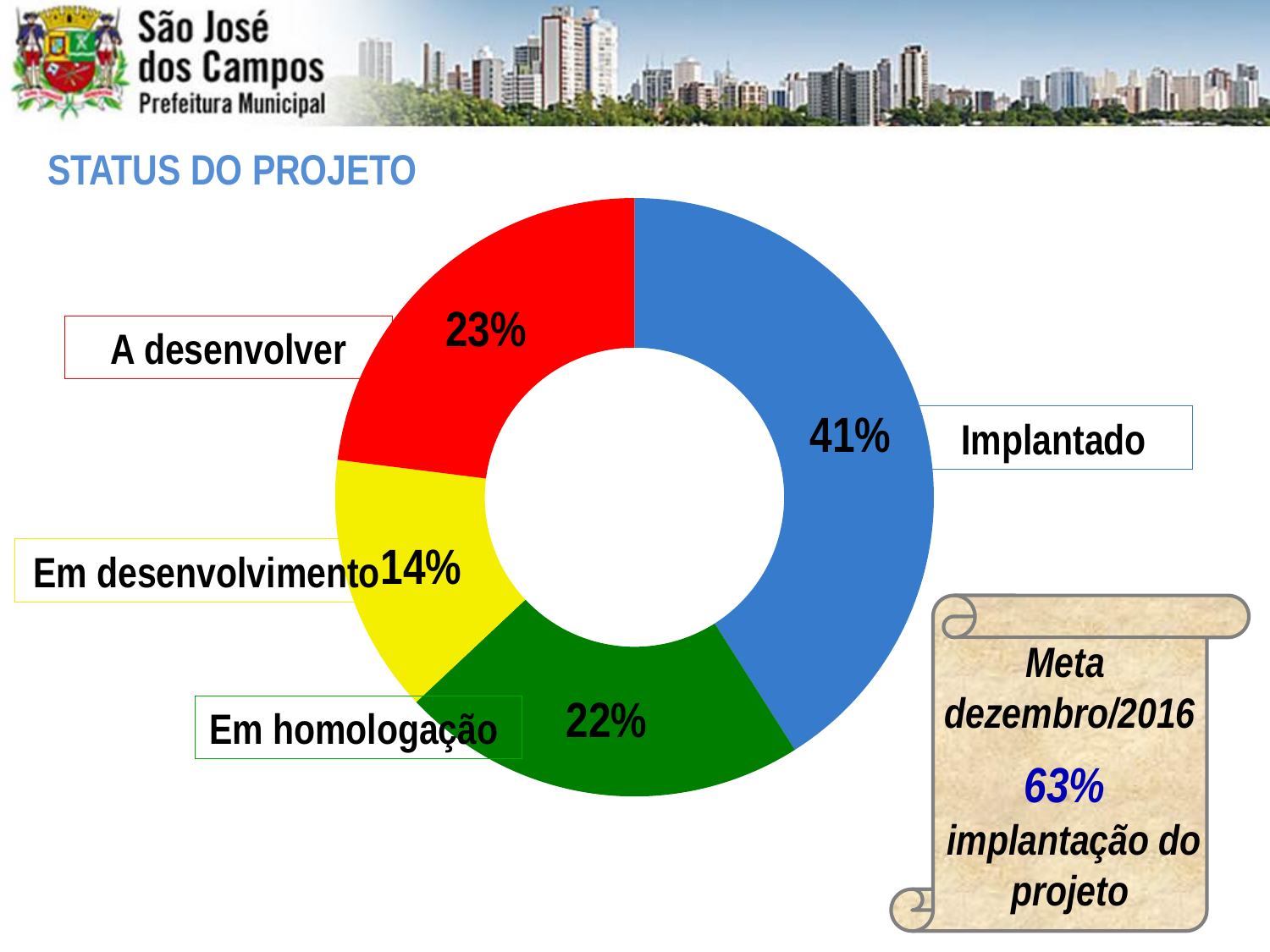
What is the title of the chart? STATUS DO PROJETO What kind of chart is shown on the slide? Pie chart (doughnut) What percentage is labelled A desenvolver? 23% Which is larger, the share for A desenvolver or the share for Em homologação? A desenvolver How many status categories does the chart show? 4 What percentage of the project is shown as Implantado? 41% What percentage is labelled Em desenvolvimento? 14% What colour is the Implantado segment? Blue What percentage is labelled Em homologação? 22% What is the difference in percentage points between Implantado and A desenvolver? 18 Which status has the largest share of the chart? Implantado Which status has the smallest share of the chart? Em desenvolvimento